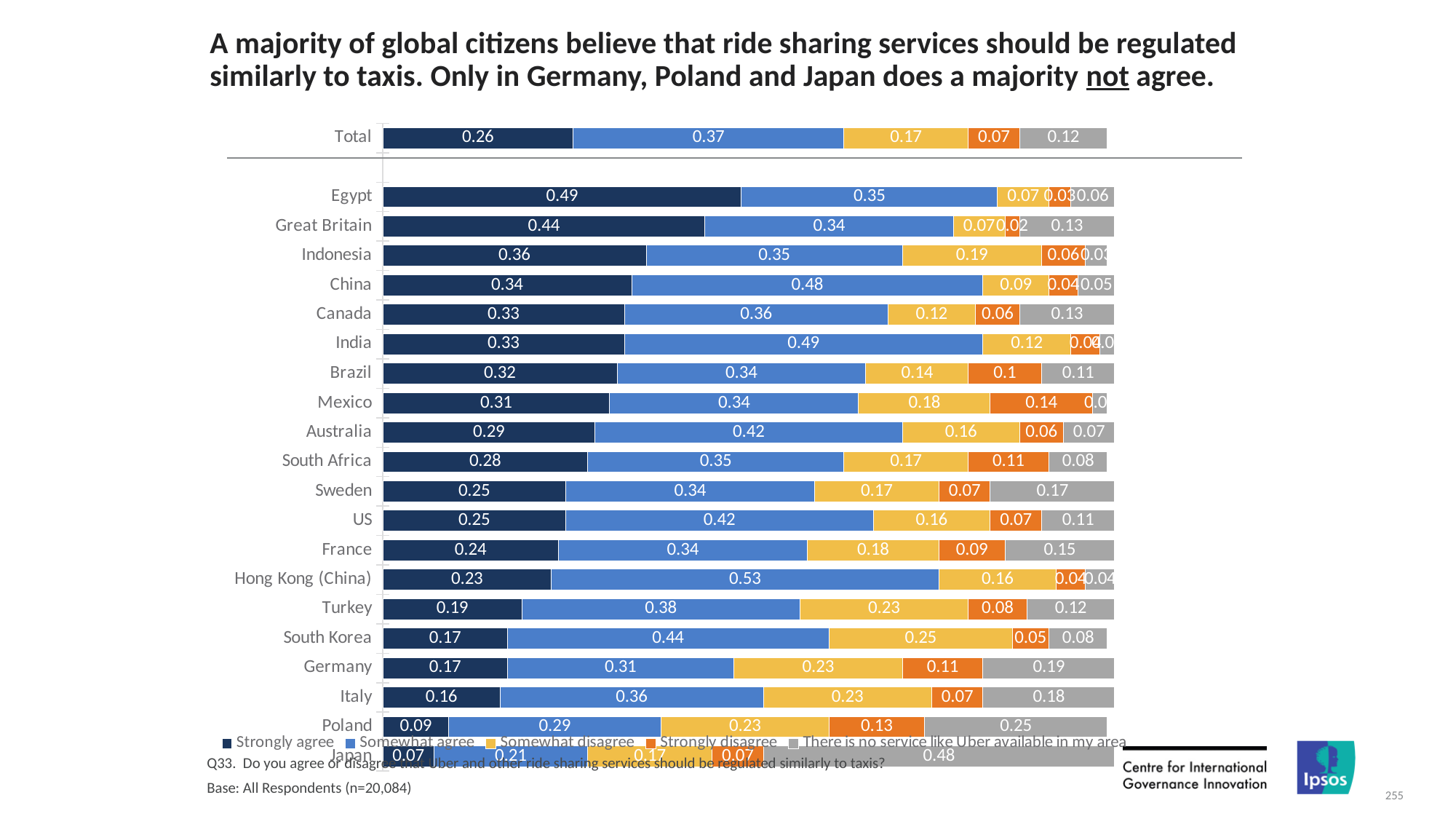
Do the 'Strongly agree' values rise or fall going down the list of countries from Egypt to Japan? Fall What kind of chart is shown on the slide? Stacked bar chart What is the difference between the 'Strongly agree' values for Egypt and Germany? 0.32 Which country has the lowest 'Strongly agree' value? Japan How many country bars are shown below the Total bar? 20 What is the 'Strongly agree' value for the Total bar? 0.26 What is the 'There is no service like Uber available in my area' value for Poland? 0.25 What is the 'Somewhat agree' value for Hong Kong (China)? 0.53 Which colour represents 'Strongly disagree' in the legend? Orange How many series does the legend list? 5 Which has a larger 'Strongly disagree' value, Mexico or Brazil? Mexico Which country has the highest 'Strongly agree' value? Egypt